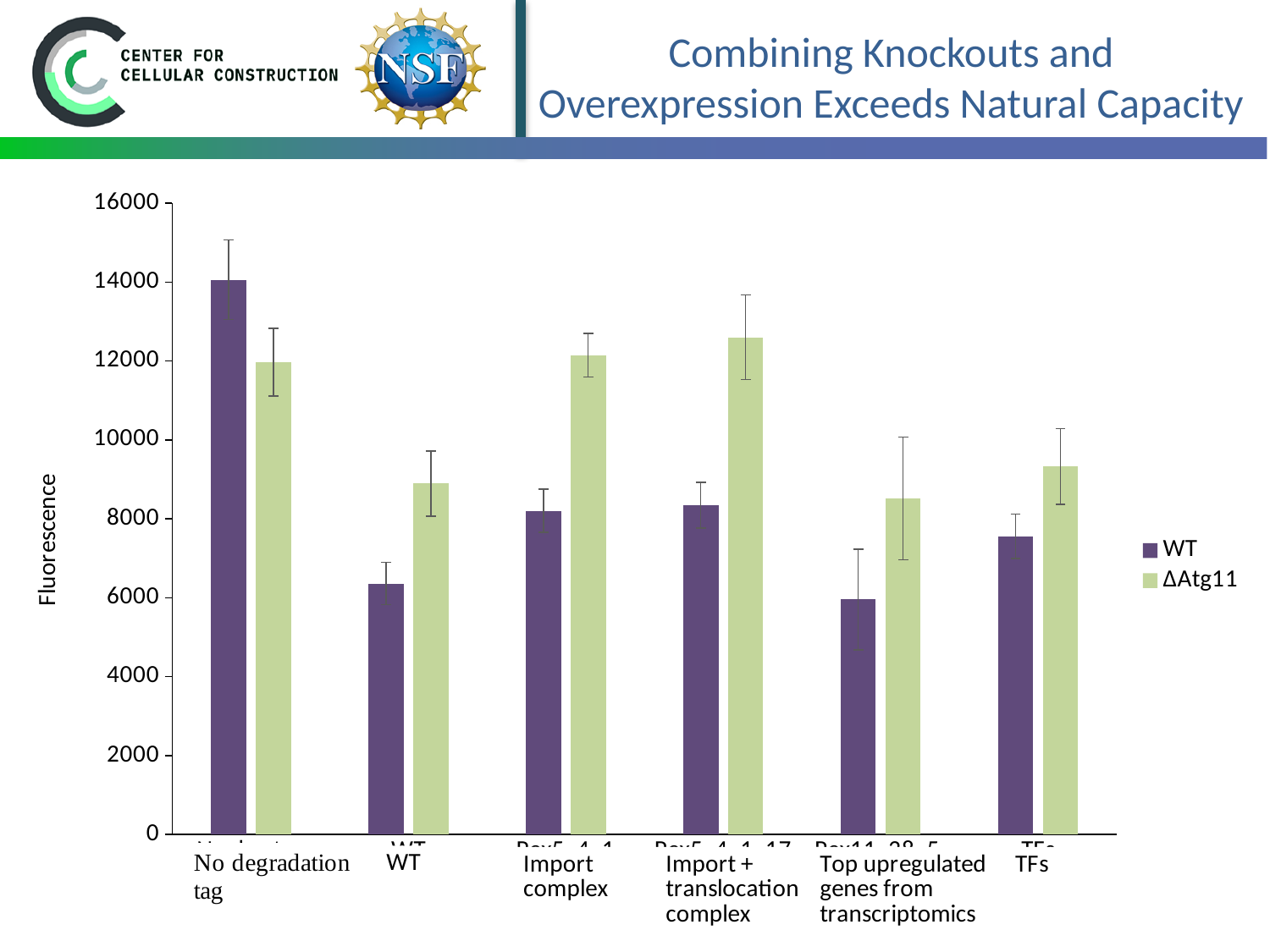
Is the WT value for the WT category greater or less than 8000? less Is the ΔAtg11 value for TFs greater or less than 8000? greater Is the WT value for Top upregulated genes from transcriptomics greater or less than 8000? less How many series does the legend list? 2 What kind of chart is shown on the slide? bar chart For the Import complex category, which series has the larger value, WT or ΔAtg11? ΔAtg11 What is the label on the y axis? Fluorescence Which two series are listed in the legend? WT and ΔAtg11 Which category has the highest WT value? No degradation tag How many categories are shown along the x axis? 6